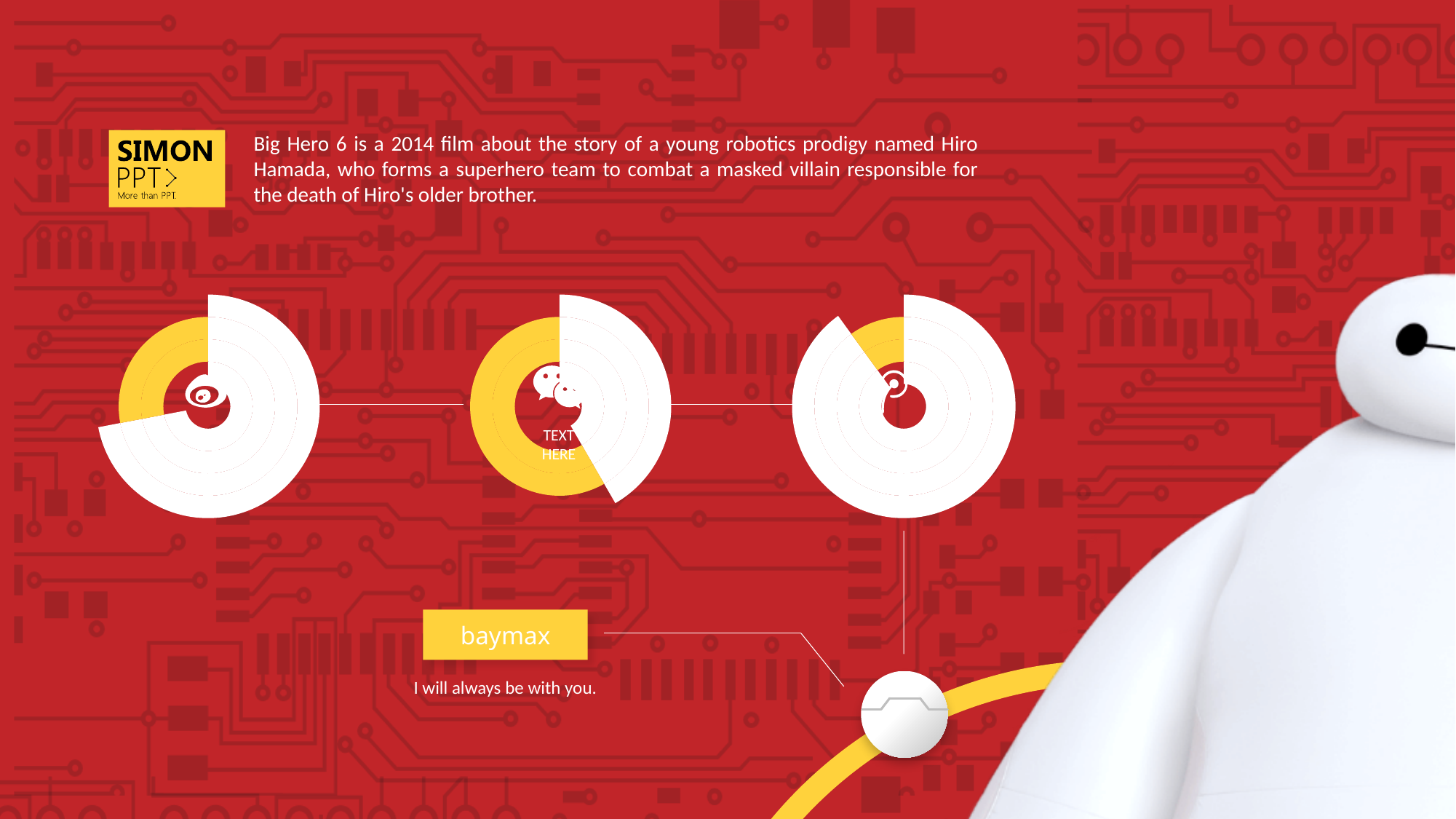
Is the yellow portion larger in the middle chart or the left chart? the middle chart What two colours are used for the segments of the circular charts? yellow and white How many circular charts are shown in the row across the middle of the slide? 3 Is the yellow portion larger in the left chart or the right chart? the left chart Which of the three circular charts has the smallest yellow portion? the right chart Which of the three circular charts has the largest yellow portion? the middle chart What placeholder text is printed inside the middle circular chart? TEXT HERE What kind of chart is shown on the left of the slide? doughnut chart